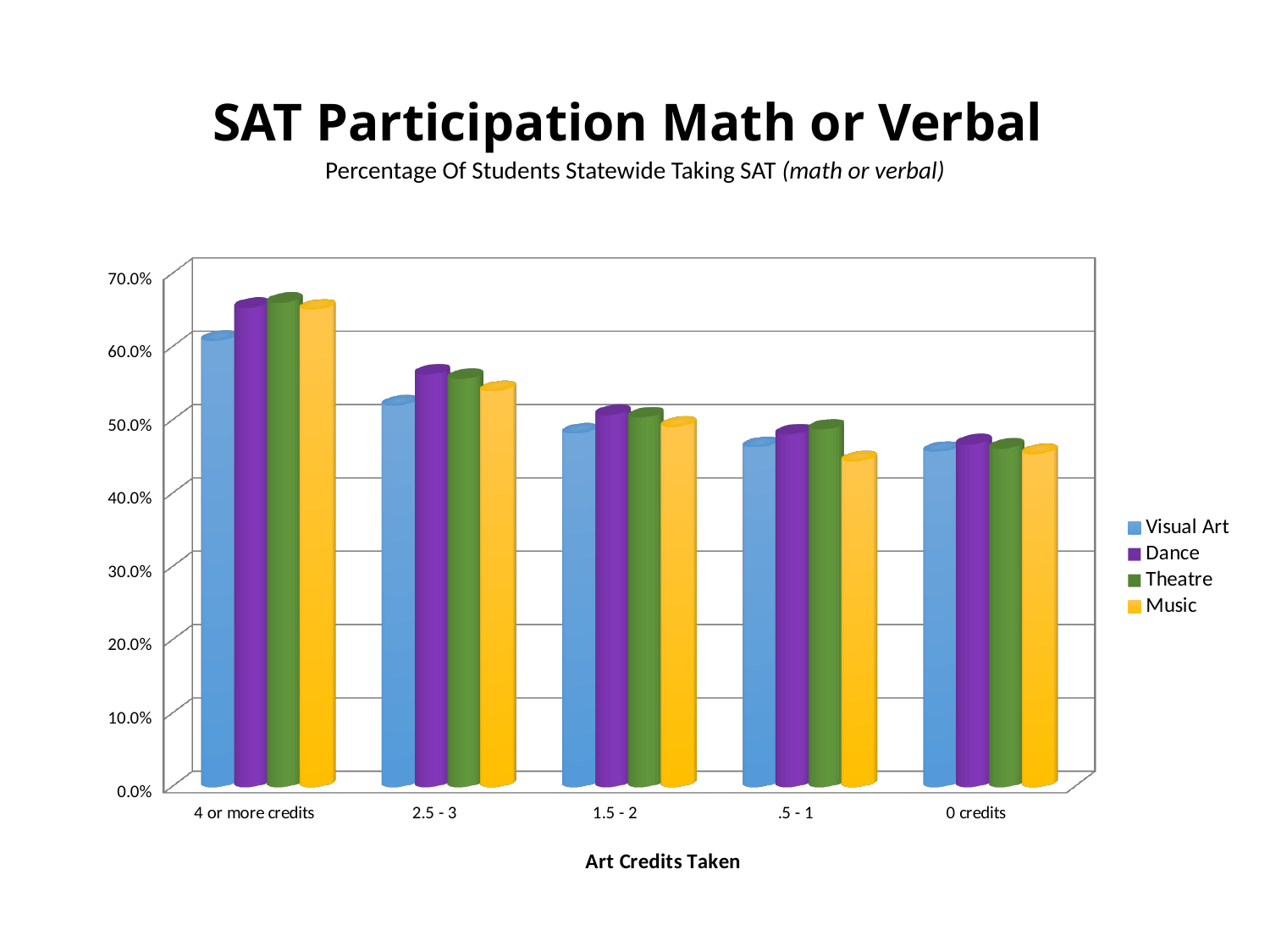
Which is larger: Visual Art at 4 or more credits or Visual Art at 0 credits? 4 or more credits Is the value for Visual Art at 0 credits greater or less than 50%? less Is the value for Visual Art at 4 or more credits greater or less than 50%? greater What kind of chart is shown on the slide? bar chart Is the value for Dance at 2.5 - 3 credits greater or less than 50%? greater What is the title of the x axis? Art Credits Taken For the Visual Art series, which art-credit category has the highest value? 4 or more credits Do the Visual Art values rise or fall moving from 4 or more credits to 0 credits along the x axis? fall How many series does the legend list? 4 How many art-credit categories are shown on the x axis? 5